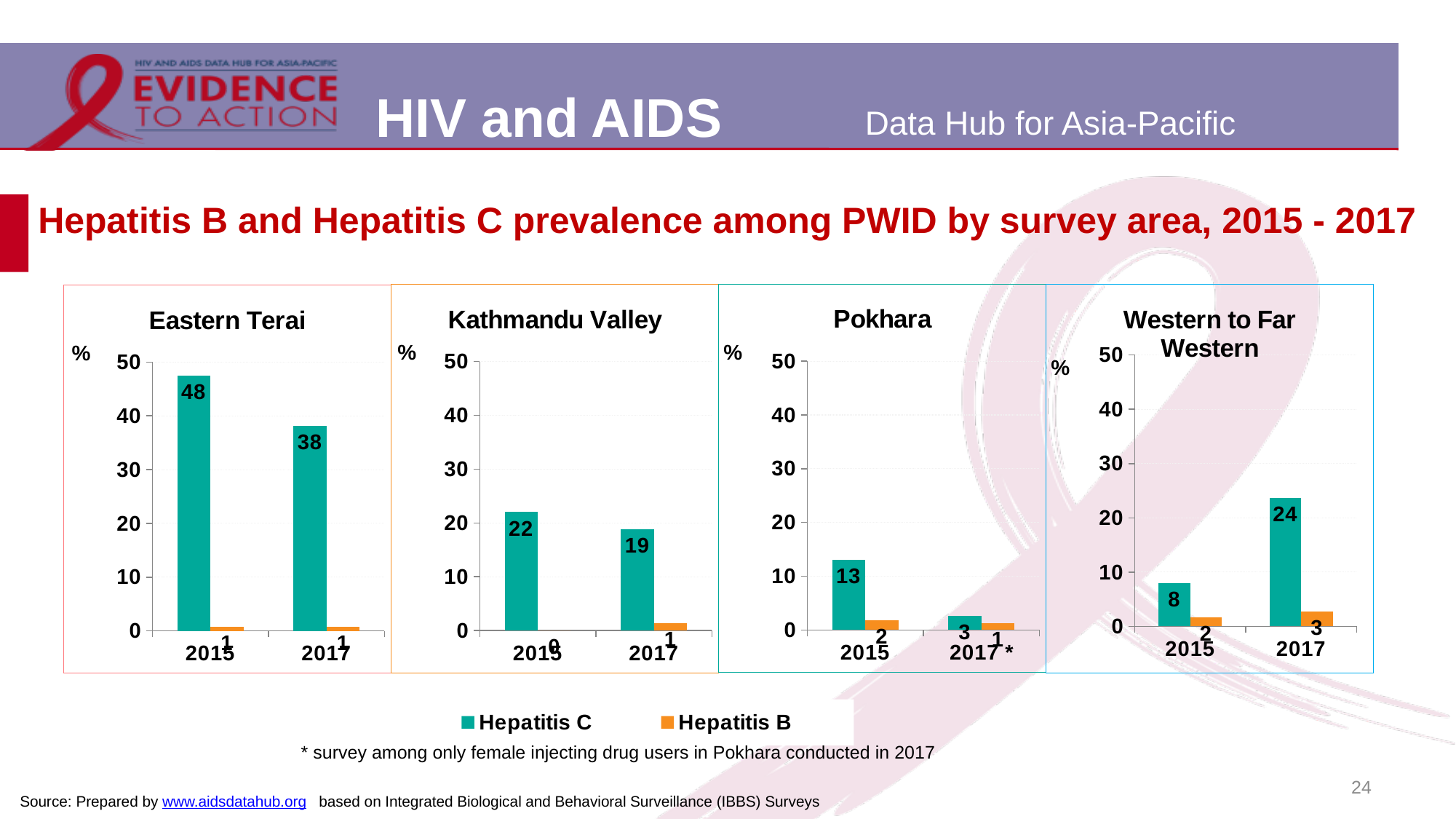
How many series does the legend list? 2 In the Eastern Terai chart, what is the difference between the Hepatitis C values for 2015 and 2017? 10 In the Eastern Terai chart, what is the Hepatitis C value for 2015? 48 What kind of chart is the Eastern Terai chart? bar chart In the Kathmandu Valley chart, what is the Hepatitis B value for 2015? 0 In the Pokhara chart, which year has the higher Hepatitis C value, 2015 or 2017? 2015 In the Kathmandu Valley chart, what is the Hepatitis C value for 2015? 22 In the Pokhara chart, what is the Hepatitis C value for 2015? 13 In the Eastern Terai chart, what is the Hepatitis C value for 2017? 38 In the Kathmandu Valley chart, is the Hepatitis C value for 2017 greater or less than 20? less In the Western to Far Western chart, does Hepatitis C rise or fall from 2015 to 2017? rise In the Western to Far Western chart, what is the Hepatitis C value for 2017? 24